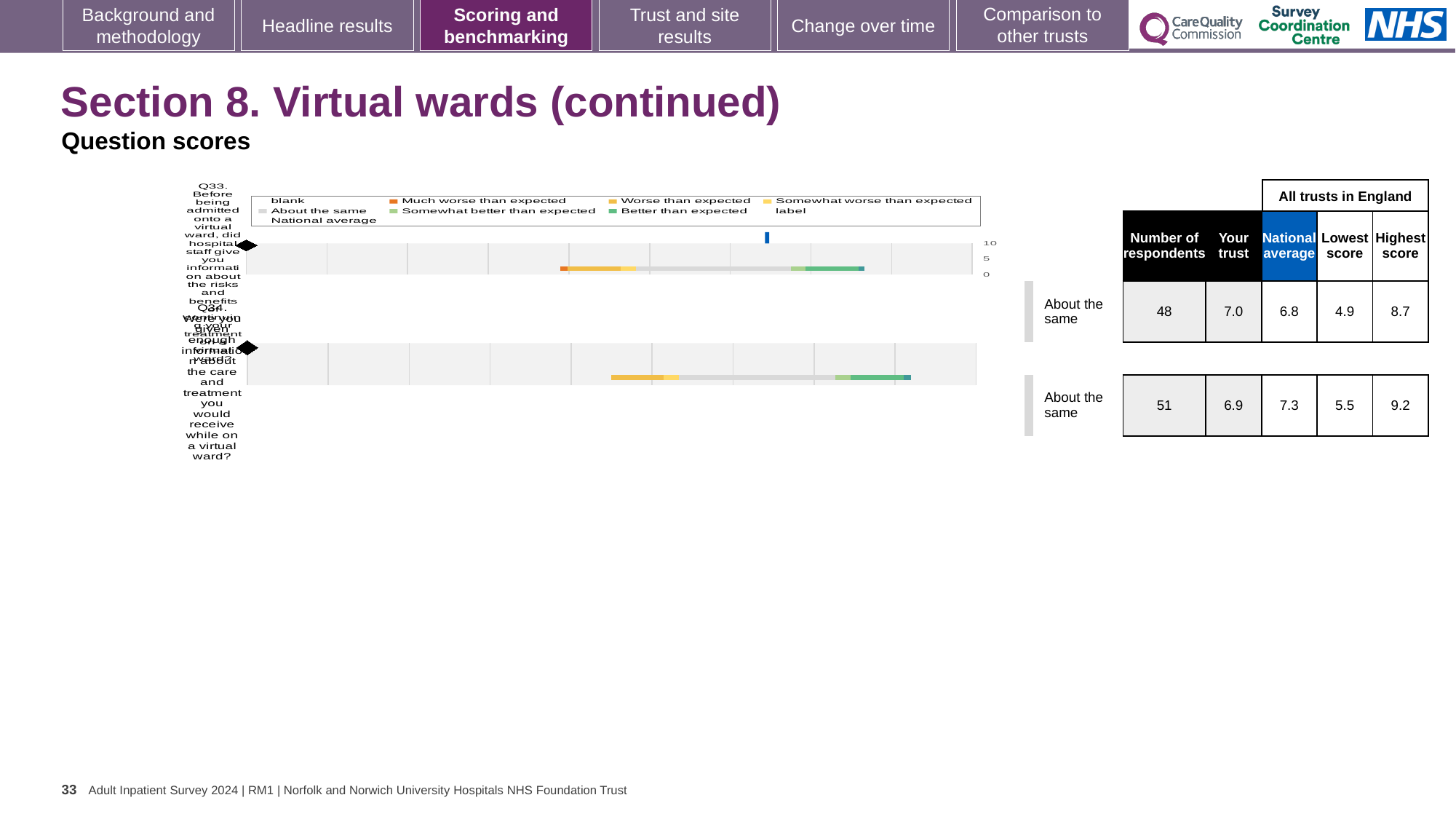
Which question had more respondents, Q33 or Q34? Q34 How many questions are plotted in the chart? 2 For Q33, which is higher: the 'Your trust' score or the national average? Your trust What is the difference between the highest score and the lowest score for Q34? 3.7 For Q34, which is higher: the 'Your trust' score or the national average? National average What is the difference between the highest score and the lowest score for Q33? 3.8 What is the highest value shown on the chart's score axis? 10 What benchmark category is shown for Q33? About the same What kind of chart is used to show the question scores on this slide? bar chart What is the national average score for Q34 (enough information about care and treatment on a virtual ward)? 7.3 How many respondents answered Q33? 48 What is the 'Your trust' score for Q33 (information about the risks and benefits of a virtual ward)? 7.0